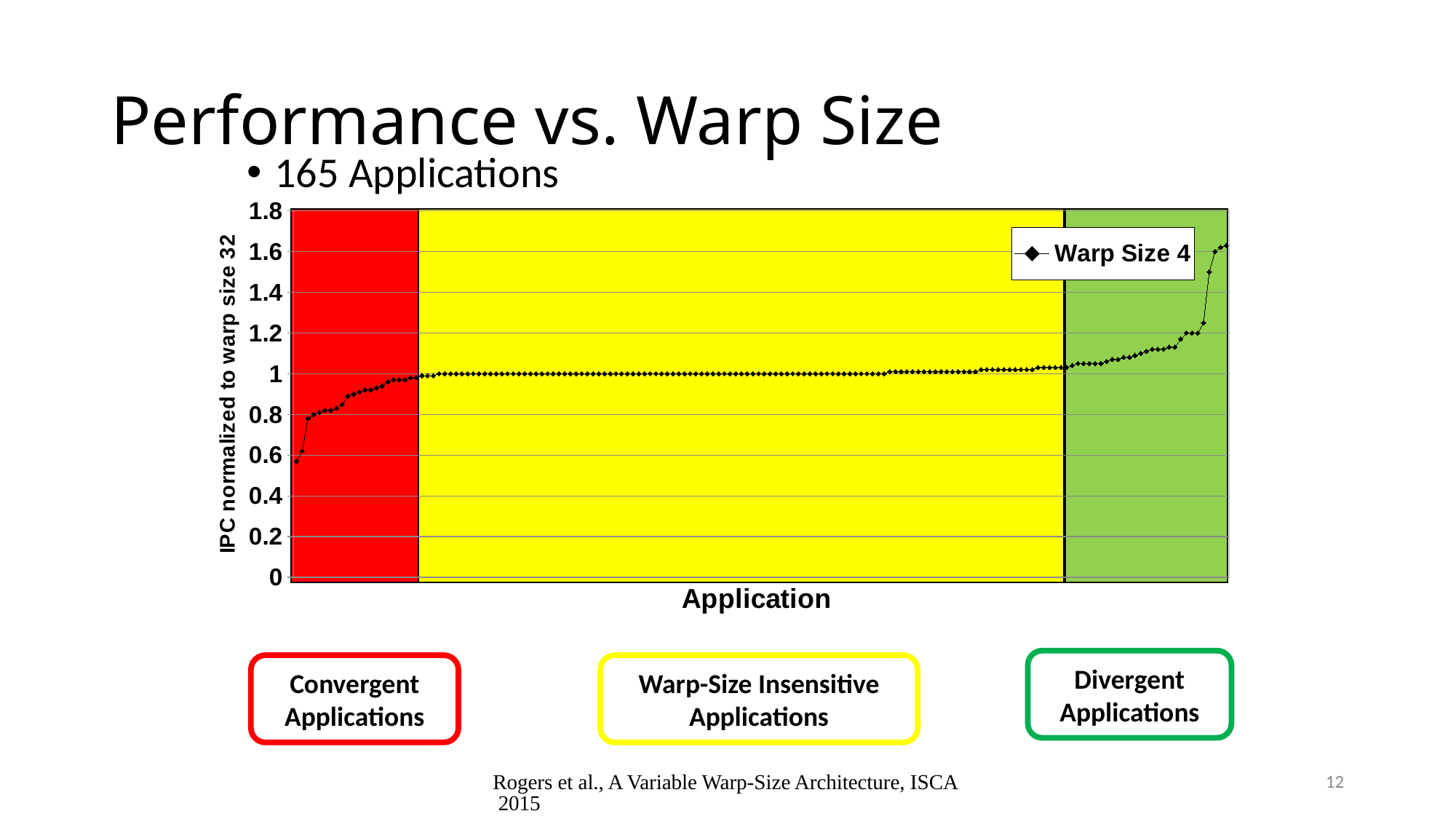
What is the name of the series shown in the chart legend? Warp Size 4 Are the values of the points in the yellow (Warp-Size Insensitive) region greater or less than 1.2? less Is the value of the rightmost point in the chart greater or less than 1.4? greater What is the highest value shown on the y axis of the chart? 1.8 How many applications are plotted in the chart, according to the slide? 165 What kind of chart is shown on the slide? line chart Is the value of the leftmost point in the chart greater or less than 0.8? less Do the plotted values rise or fall from left to right along the x axis? rise What is the label of the y axis of the chart? IPC normalized to warp size 32 How many series does the chart legend list? 1